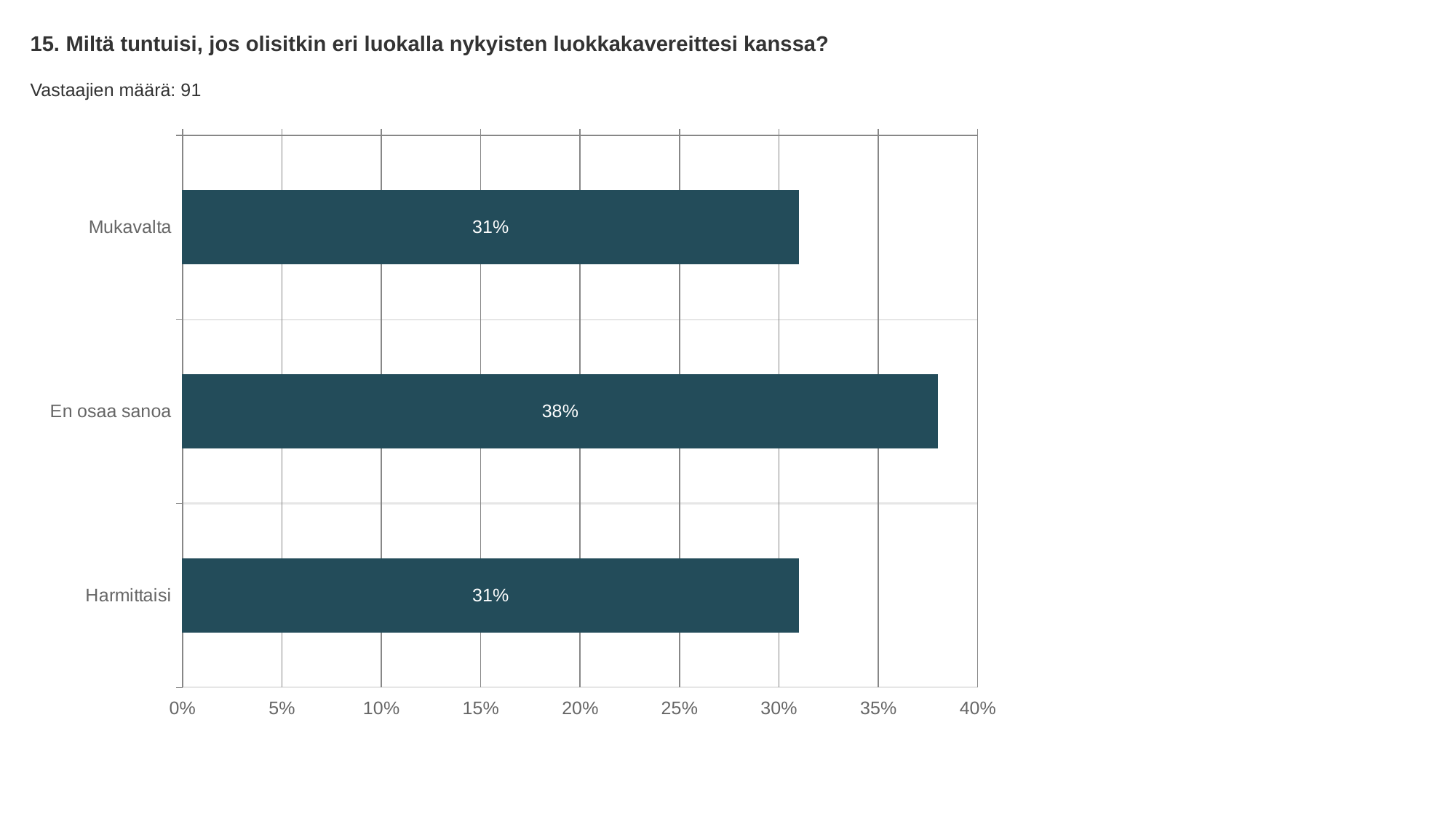
Which is larger, the value for En osaa sanoa or the value for Harmittaisi? En osaa sanoa What is the maximum value shown on the x axis? 40% Is the value for En osaa sanoa greater or less than 35%? greater How many categories are shown in the chart? 3 What is the difference between the values for En osaa sanoa and Mukavalta? 7% What is the value for En osaa sanoa? 38% How many respondents (Vastaajien määrä) are reported on the slide? 91 Is the value for Mukavalta greater or less than 35%? less What is the value for Mukavalta? 31% What kind of chart is shown on the slide? bar chart Which category has the highest value? En osaa sanoa What is the value for Harmittaisi? 31%